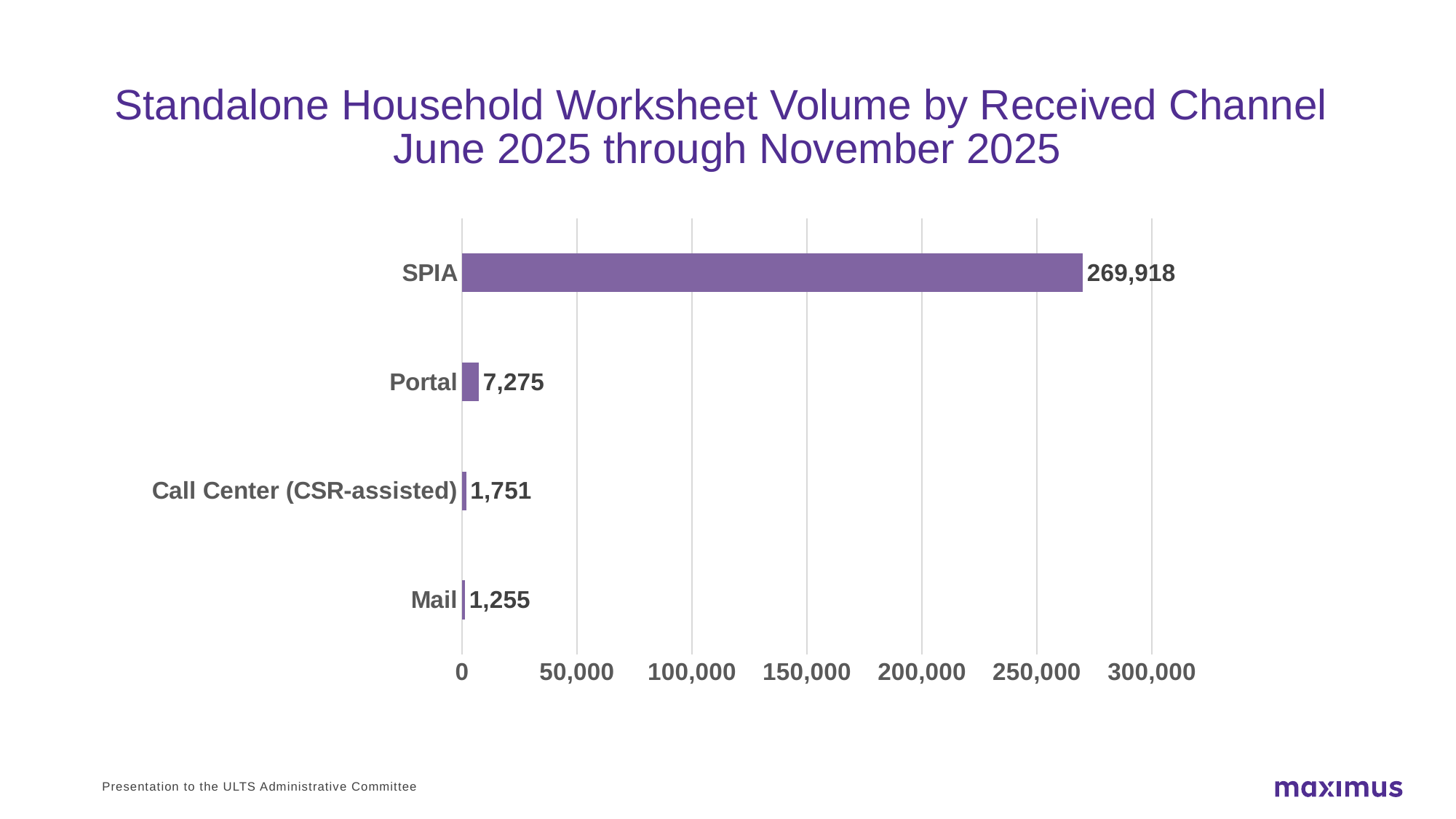
What is the difference between the Call Center (CSR-assisted) and Mail volumes? 496 What is the volume for Mail? 1,255 What is the volume for Portal? 7,275 Which channel has the highest volume? SPIA Is the value for SPIA greater or less than 250,000? greater What is the volume for Call Center (CSR-assisted)? 1,751 Which channel has the lowest volume? Mail How many channels are shown in the chart? 4 What is the volume for SPIA? 269,918 Which has a larger volume, Portal or Call Center (CSR-assisted)? Portal What is the difference between the SPIA and Portal volumes? 262,643 What kind of chart is shown on the slide? Bar chart